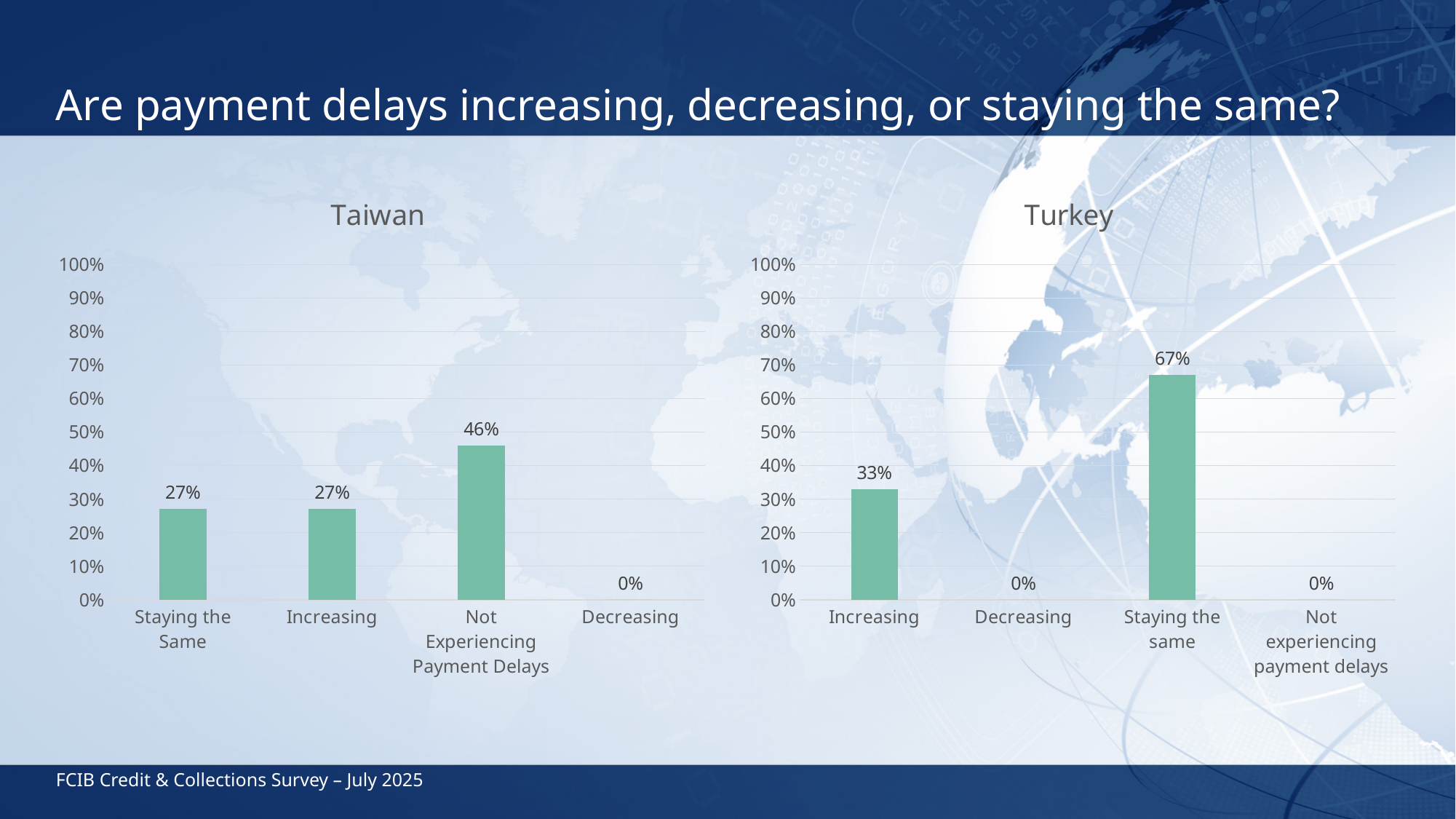
In the Taiwan chart, what is the difference between Not Experiencing Payment Delays and Staying the Same? 19% In the Taiwan chart, which category has the highest value? Not Experiencing Payment Delays In the Turkey chart, which category has the highest value? Staying the same In the Taiwan chart, what is the value for Increasing? 27% In the Turkey chart, what is the value for Staying the same? 67% What kind of chart is the Turkey chart? Bar chart How many categories are shown in the Taiwan chart? 4 Which is larger: Staying the same in the Turkey chart or Not Experiencing Payment Delays in the Taiwan chart? Staying the same in the Turkey chart In the Turkey chart, what is the value for Increasing? 33% In the Taiwan chart, what is the value for Not Experiencing Payment Delays? 46% In the Turkey chart, what is the difference between Staying the same and Increasing? 34% In the Turkey chart, what is the value for Decreasing? 0%